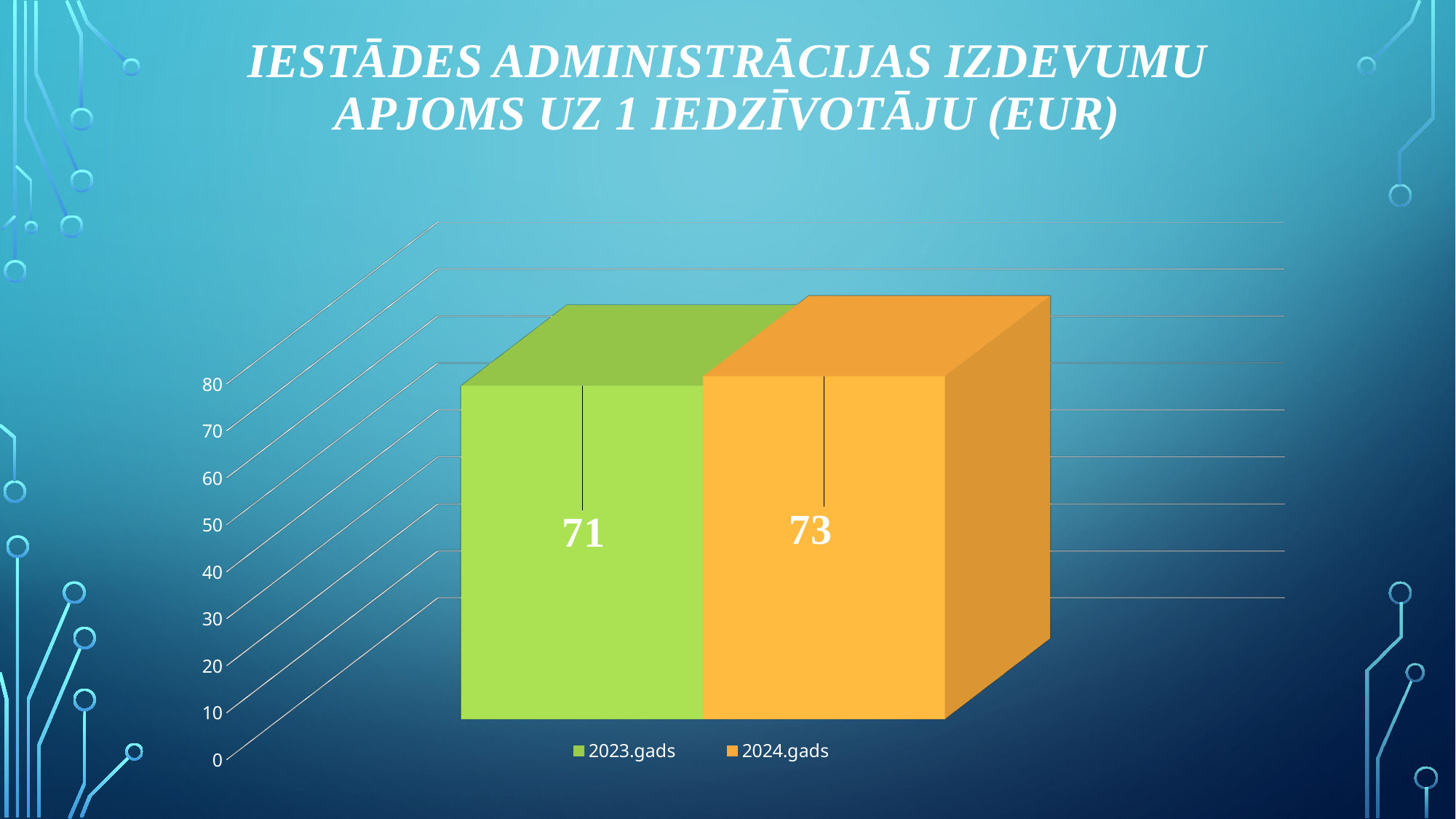
What colour is the bar for 2024.gads? Orange Is the value for 2023.gads greater or less than 80? less How many series does the legend list? 2 What kind of chart is shown on the slide? Bar chart Do the values rise or fall from 2023.gads to 2024.gads? Rise What is the difference between the 2024.gads value and the 2023.gads value? 2 Which series has the higher value, 2023.gads or 2024.gads? 2024.gads Which series has the lower value? 2023.gads What is the highest value shown on the vertical axis? 80 What is the value for 2024.gads? 73 What is the value for 2023.gads? 71 Is the value for 2024.gads larger than the value for 2023.gads? Yes